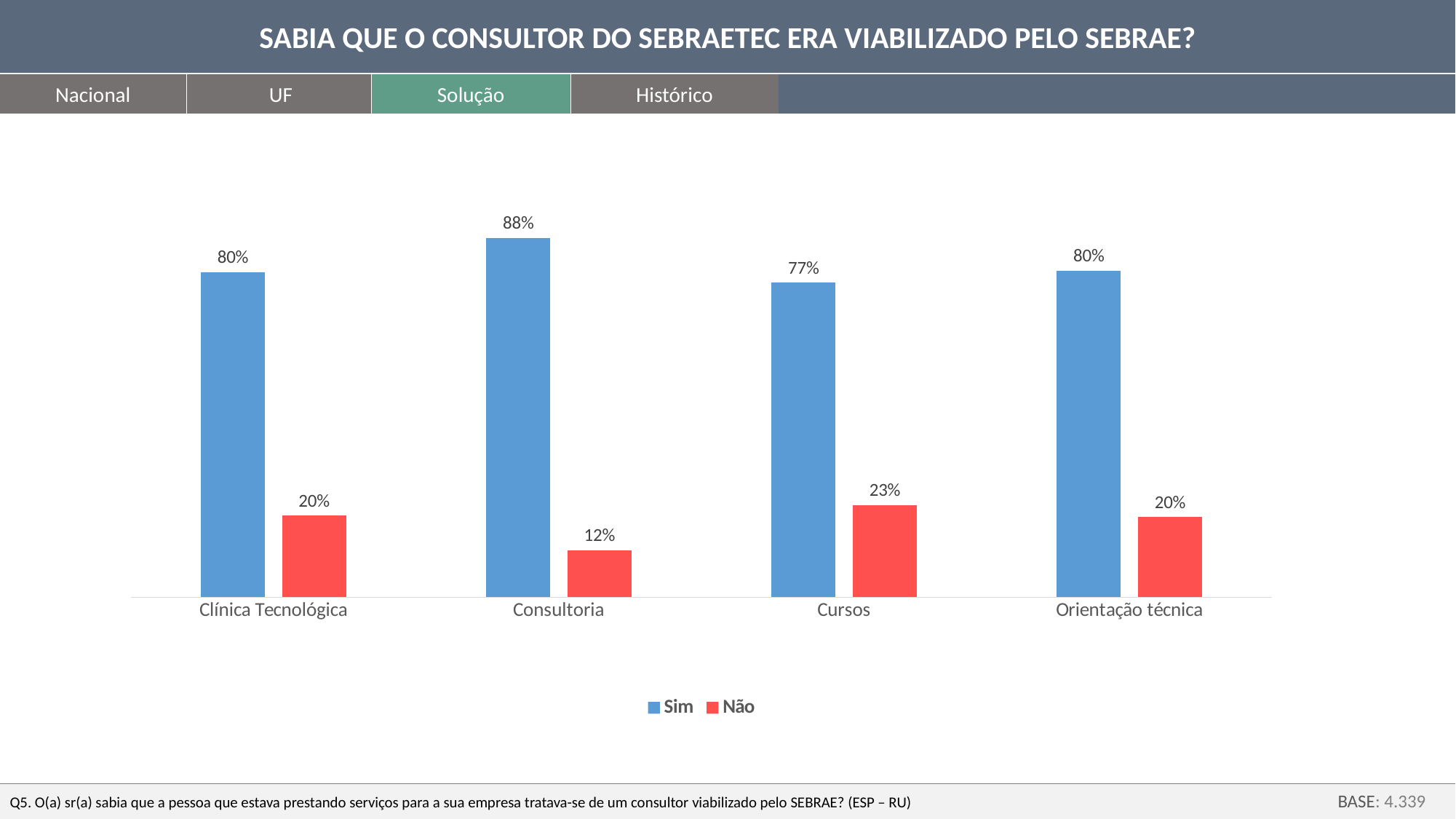
How many series does the legend list? 2 Which category has the highest 'Sim' value? Consultoria Which category has the lowest 'Não' value? Consultoria How many categories are shown on the x axis? 4 What is the 'Não' value for Cursos? 23% What is the difference between the 'Sim' and 'Não' values for Cursos? 54% What kind of chart is shown on the slide? Bar chart Which is larger: the 'Sim' value for Consultoria or the 'Sim' value for Cursos? Consultoria What is the 'Sim' value for Orientação técnica? 80% Which series is shown in red in the legend? Não What is the 'Sim' value for Consultoria? 88% What is the 'Não' value for Consultoria? 12%